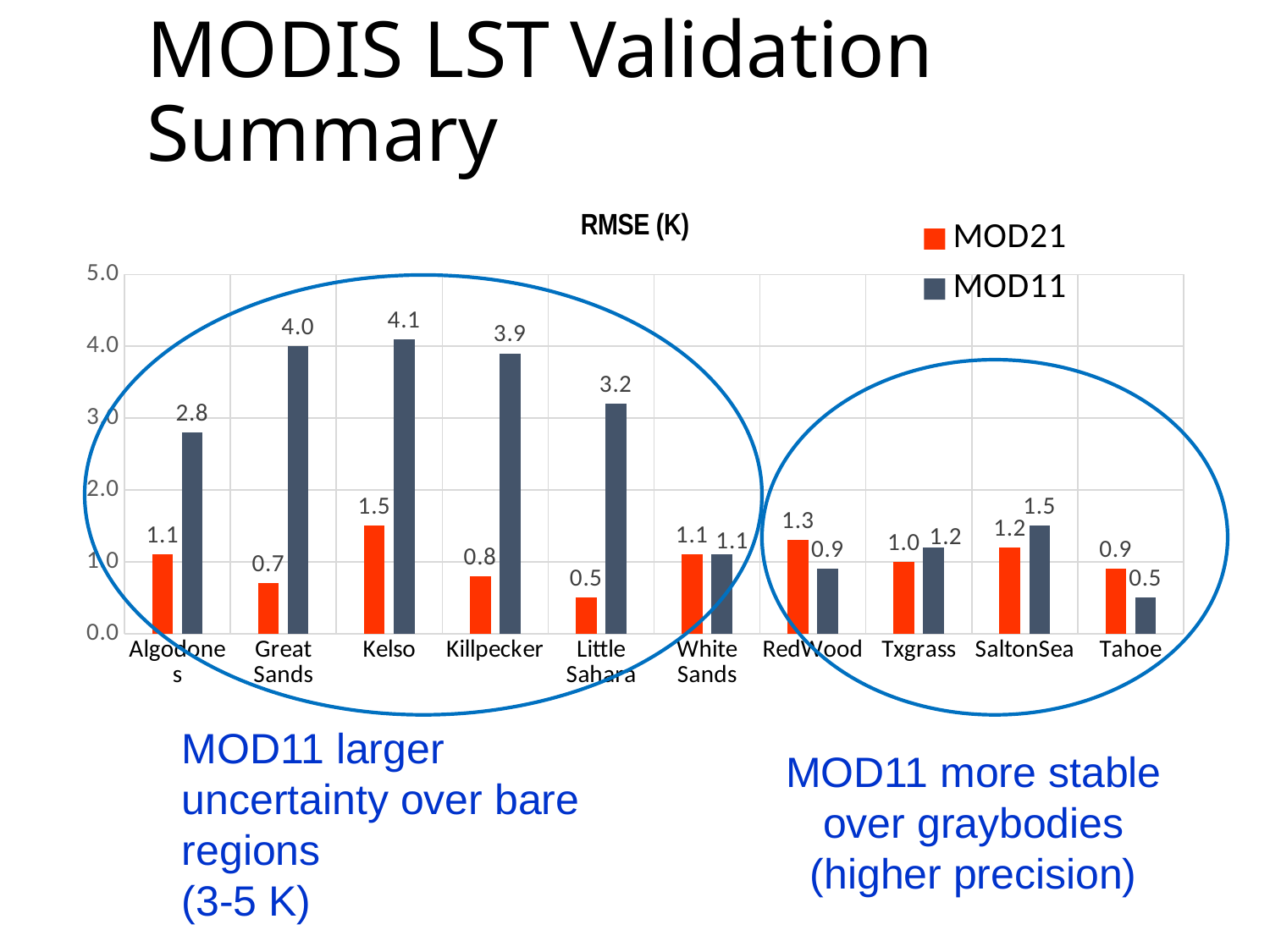
How many series does the legend list? 2 What type of chart is shown on the slide? Bar chart What is the MOD11 RMSE value for Kelso? 4.1 How many sites are shown on the x axis? 10 What is the difference between the MOD11 and MOD21 values for Killpecker? 3.1 Which site has the lowest MOD11 RMSE? Tahoe Is the MOD11 value for Little Sahara greater or less than 3.0? greater Which site has the highest MOD21 RMSE? Kelso Which site has the highest MOD11 RMSE? Kelso At RedWood, which series has the larger RMSE, MOD21 or MOD11? MOD21 What is the MOD21 RMSE value for Little Sahara? 0.5 What is the MOD11 value for Great Sands? 4.0